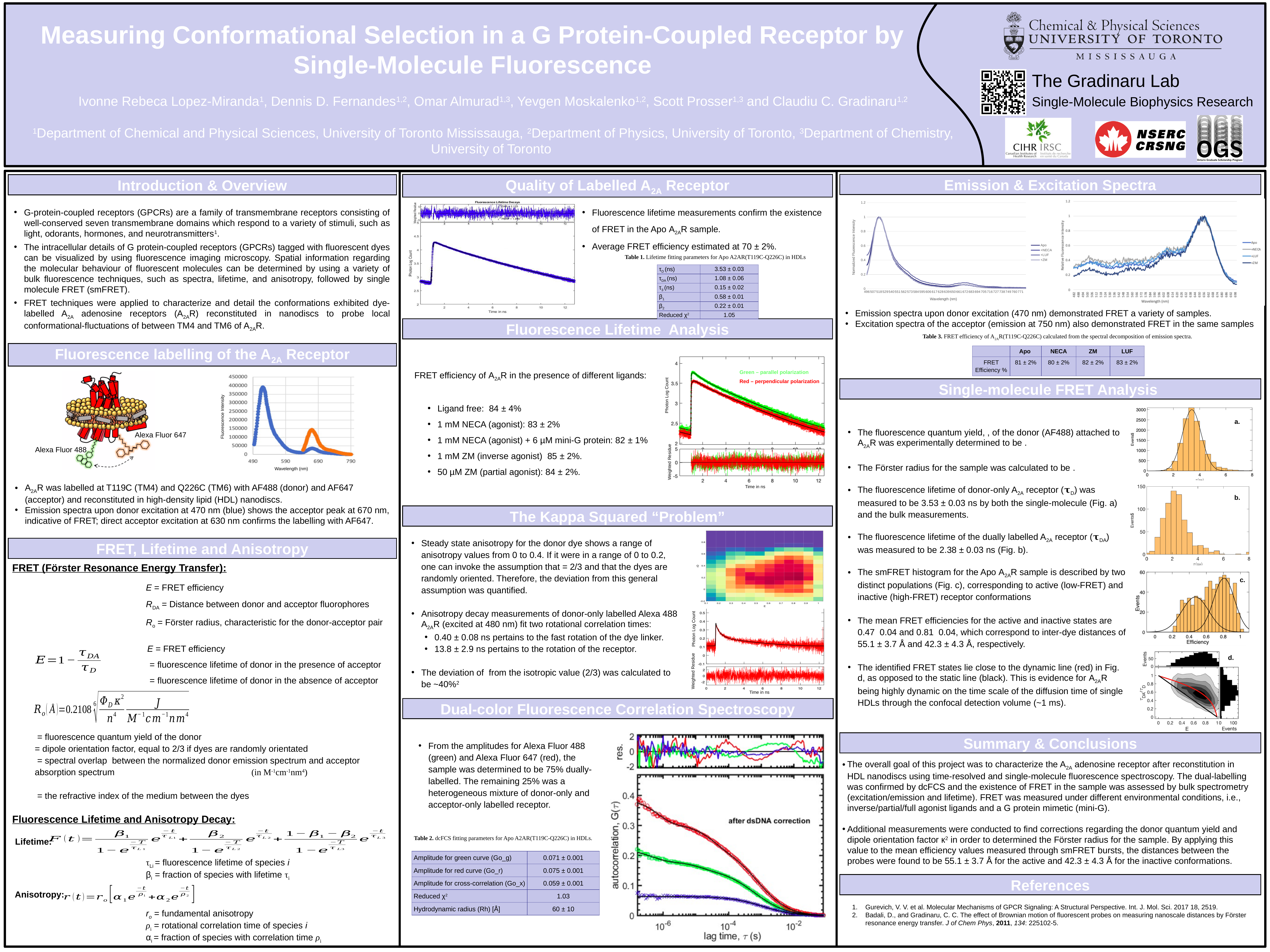
In the 'Dual-color Fluorescence Correlation Spectroscopy' chart, which curve has the highest autocorrelation at the shortest lag time? red In the lifetime decay chart of the 'Fluorescence Lifetime Analysis' section, does the Photon Log Count rise or fall as Time in ns increases after the initial peak? fall In the 'Dual-color Fluorescence Correlation Spectroscopy' chart, is the blue curve's autocorrelation at the shortest lag time greater or less than 0.1? less What kind of chart is Fig. c in the 'Single-molecule FRET Analysis' section? bar chart In the 'Emission & Excitation Spectra' section, how many series does the legend of the left chart list? 4 What is the x-axis label of the spectrum chart in the 'Fluorescence labelling of the A2A Receptor' section? Wavelength (nm) In the spectrum chart of the 'Fluorescence labelling of the A2A Receptor' section, is the peak of the orange curve greater or less than 200000? less In the spectrum chart of the 'Fluorescence labelling of the A2A Receptor' section, is the peak of the blue curve greater or less than 350000? greater What kind of chart is the spectrum chart in the 'Fluorescence labelling of the A2A Receptor' section? line chart In the 'Emission & Excitation Spectra' section, what are the legend entries of the left chart? Apo, +NECA, +LUF, +ZM In the spectrum chart of the 'Fluorescence labelling of the A2A Receptor' section, which curve reaches a higher peak, the blue one or the orange one? blue